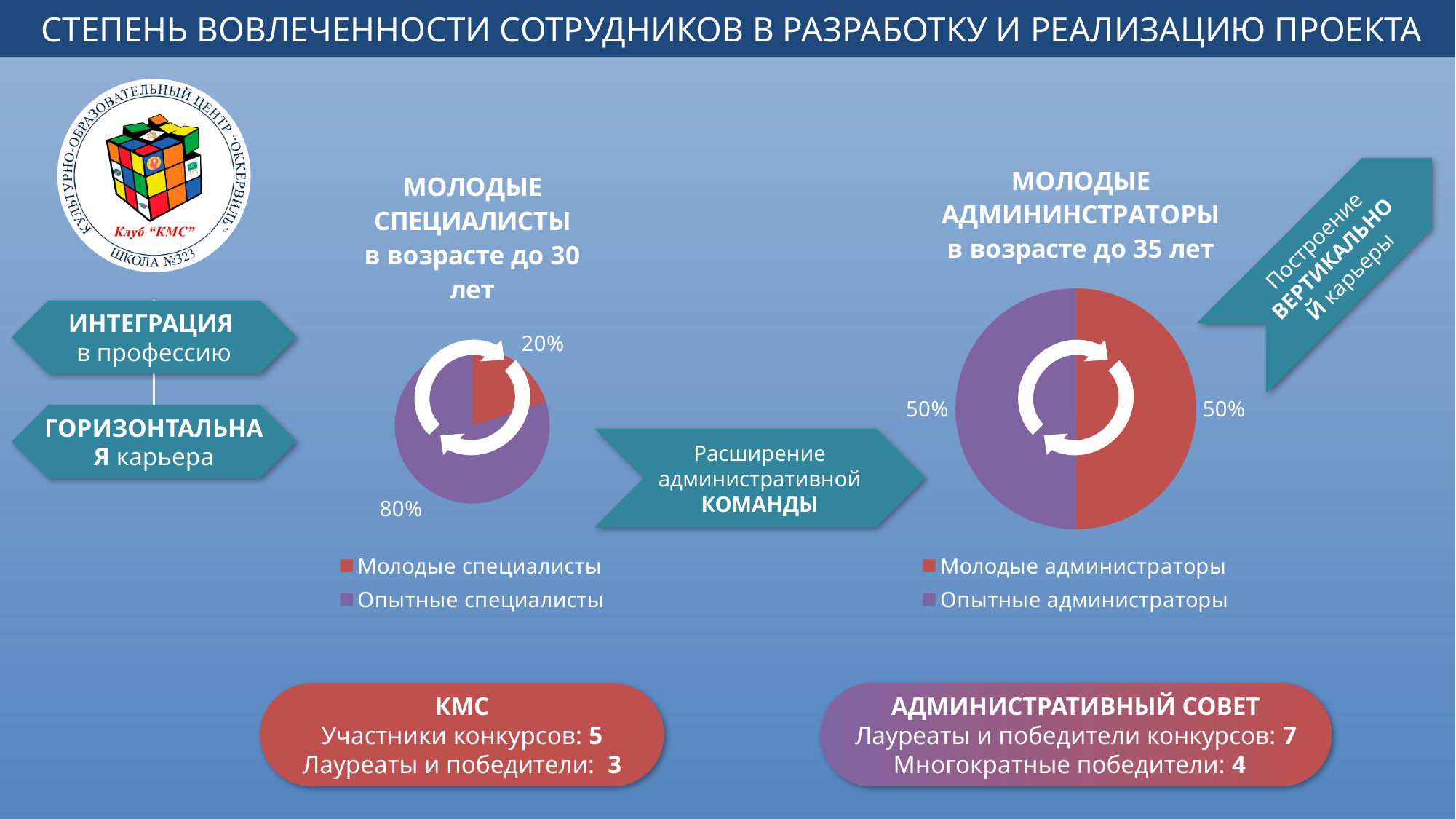
On the left pie chart (young specialists under 30), which category has the smaller slice? Молодые специалисты On the left pie chart (young specialists under 30), which category has the larger slice? Опытные специалисты On the right pie chart (young administrators under 35), how many slices does the pie have? 2 On the left pie chart (young specialists under 30), what share is labelled for 'Молодые специалисты'? 20% How many entries does the legend of the left pie chart (young specialists under 30) list? 2 On the left pie chart (young specialists under 30), what is the difference in percentage points between 'Опытные специалисты' and 'Молодые специалисты'? 60 On the right pie chart (young administrators under 35), what share is labelled for 'Молодые администраторы'? 50% On the left pie chart (young specialists under 30), what colour is the slice for 'Молодые специалисты'? Red On the left pie chart (young specialists under 30), what share is labelled for 'Опытные специалисты'? 80% On the right pie chart (young administrators under 35), what colour is the slice for 'Опытные администраторы'? Purple On the right pie chart (young administrators under 35), what share is labelled for 'Опытные администраторы'? 50% What type of chart is used for the young administrators under 35 on the right? Pie chart